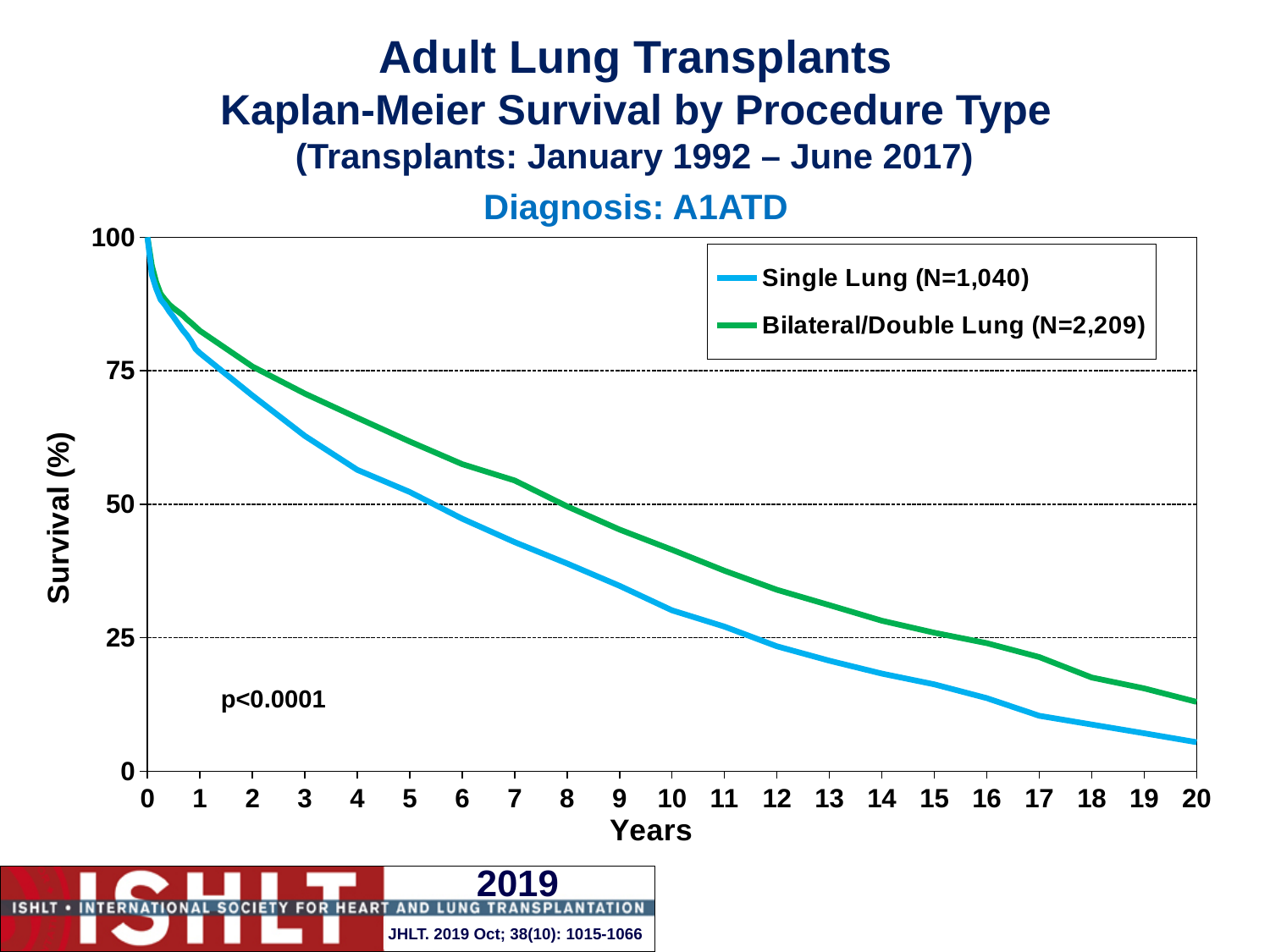
How many series does the legend list? 2 Is the survival value for Bilateral/Double Lung at 5 years greater or less than 50? greater Is the survival value for Single Lung at 15 years greater or less than 25? less Is the survival value for Bilateral/Double Lung at 10 years greater or less than 50? less What p-value is printed on the chart? p<0.0001 At 10 years, which series has the higher survival: Single Lung or Bilateral/Double Lung? Bilateral/Double Lung At 15 years, which series has the lower survival: Single Lung or Bilateral/Double Lung? Single Lung What kind of chart is shown on the slide? line chart Do the survival curves rise or fall as years increase? fall What is the N shown in the legend for Bilateral/Double Lung? 2,209